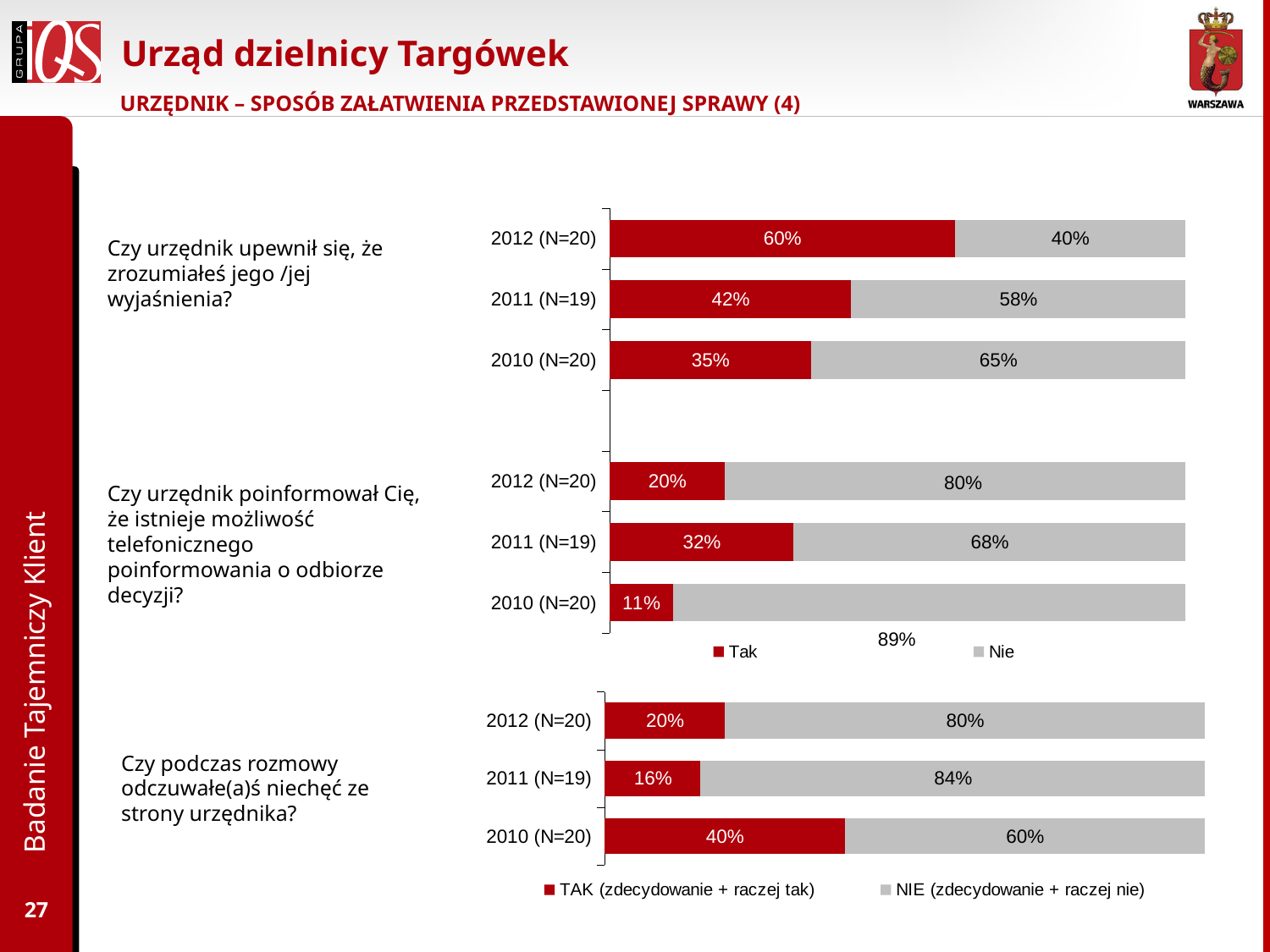
In the middle chart (Czy urzędnik poinformował Cię o możliwości telefonicznego poinformowania...), what is the 'Tak' value for 2010 (N=20)? 11% What type of chart is used on this slide? Stacked bar chart In the top chart (Czy urzędnik upewnił się...), what is the difference between the 'Tak' values for 2012 and 2010? 25 percentage points How many series does the legend of the bottom chart list? 2 In the middle chart (Czy urzędnik poinformował Cię...), what is the 'Nie' value for 2011 (N=19)? 68% In the middle chart (Czy urzędnik poinformował Cię...), which year has the lowest 'Tak' share? 2010 (N=20) In the top chart (Czy urzędnik upewnił się...), which year has the highest 'Tak' share? 2012 (N=20) In the bottom chart (Czy podczas rozmowy odczuwałe(a)ś niechęć...), is the NIE value for 2012 larger or smaller than the NIE value for 2011? smaller In the top chart (Czy urzędnik upewnił się...), what is the 'Nie' value for 2010 (N=20)? 65% In the bottom chart (Czy podczas rozmowy odczuwałe(a)ś niechęć...), which year has the highest TAK share? 2010 (N=20) In the top chart (Czy urzędnik upewnił się, że zrozumiałeś jego/jej wyjaśnienia?), what is the 'Tak' value for 2012 (N=20)? 60% In the bottom chart (Czy podczas rozmowy odczuwałe(a)ś niechęć ze strony urzędnika?), what is the TAK value for 2011 (N=19)? 16%